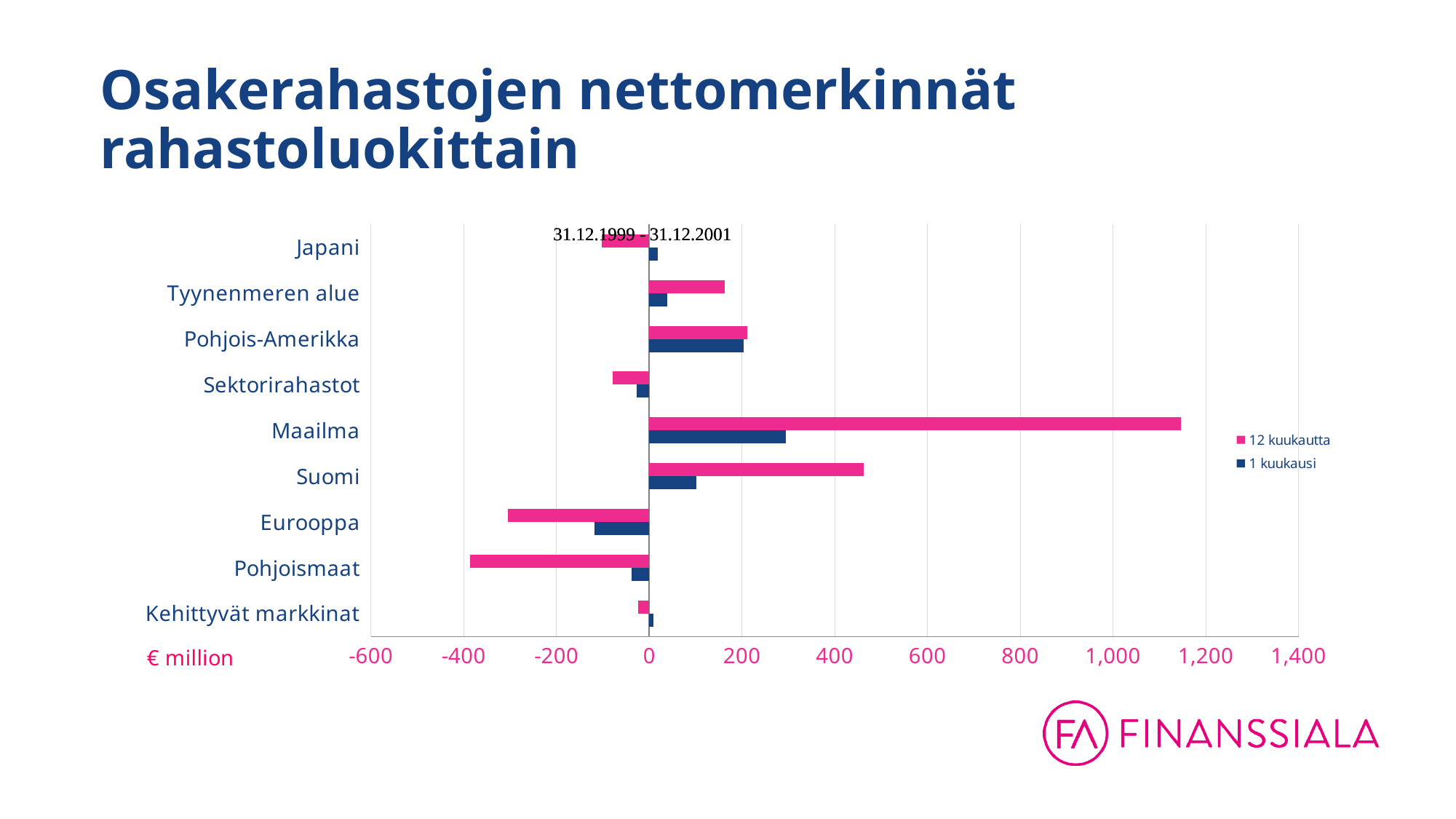
How many fund categories are plotted on the chart? 9 What kind of chart is shown on the slide? bar chart Which category has the lowest value for the 12 kuukautta series? Pohjoismaat For the 12 kuukautta series, which is larger: Suomi or Pohjois-Amerikka? Suomi For the 1 kuukausi series, which is larger: Maailma or Suomi? Maailma Is the 12 kuukautta value for Maailma greater or less than 1,000? greater Is the 12 kuukautta value for Suomi greater or less than 400? greater Which category has the highest value for the 12 kuukautta series? Maailma Is the 12 kuukautta value for Pohjoismaat greater or less than -200? less How many series does the legend list? 2 What unit is shown for the x axis of the chart? € million